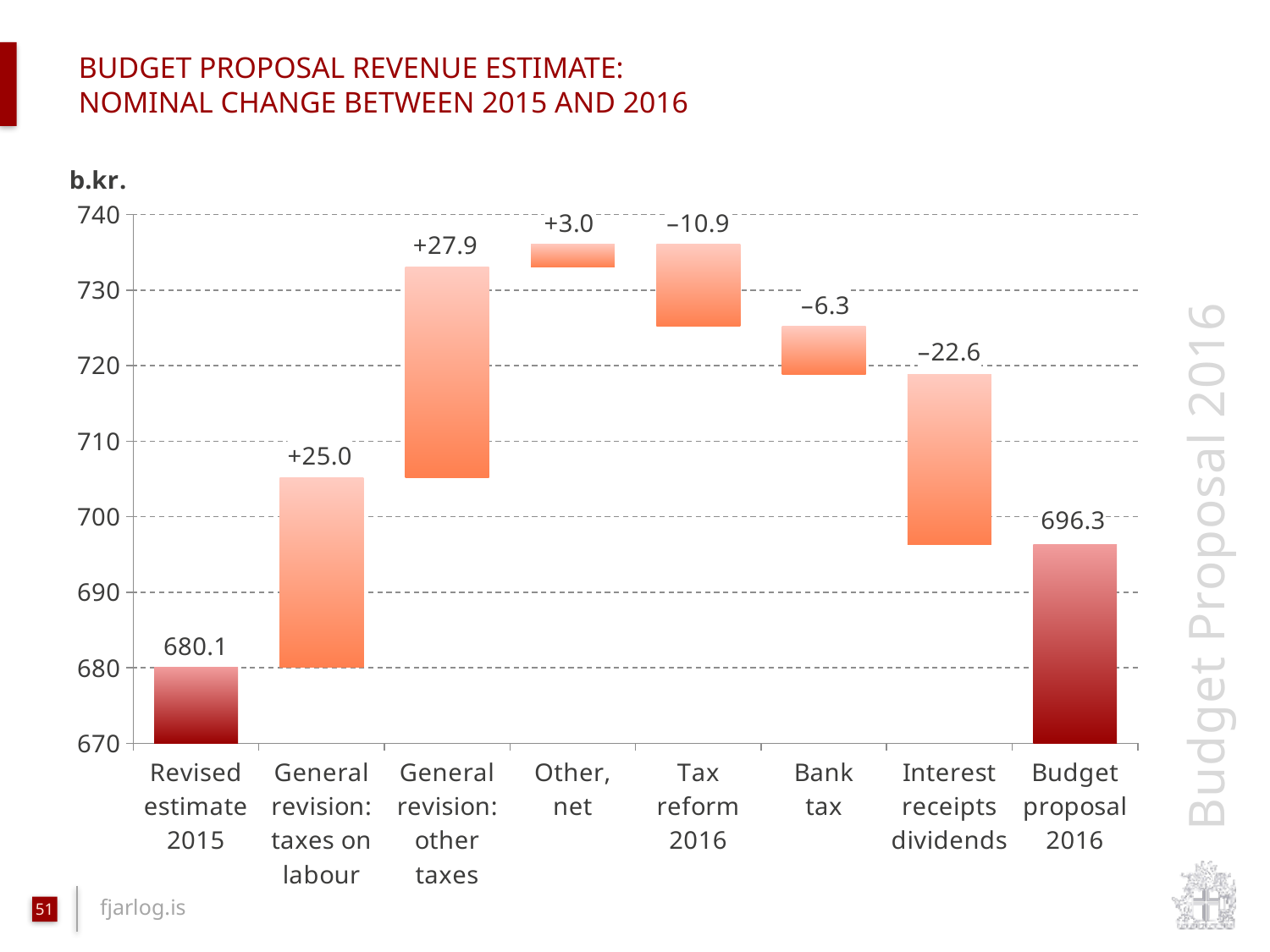
What is the value for Revised estimate 2015? 680.1 Which category shows the largest negative change? Interest receipts dividends Which category shows the largest positive change? General revision: other taxes What unit is shown above the vertical axis? b.kr. What is the change shown for Bank tax? –6.3 How many categories are shown on the x axis? 8 What is the difference between Budget proposal 2016 and Revised estimate 2015? 16.2 What kind of chart is shown on the slide? bar chart What is the value for Budget proposal 2016? 696.3 What is the change shown for Interest receipts dividends? –22.6 What is the change shown for General revision: taxes on labour? +25.0 Which change is larger: General revision: taxes on labour or General revision: other taxes? General revision: other taxes